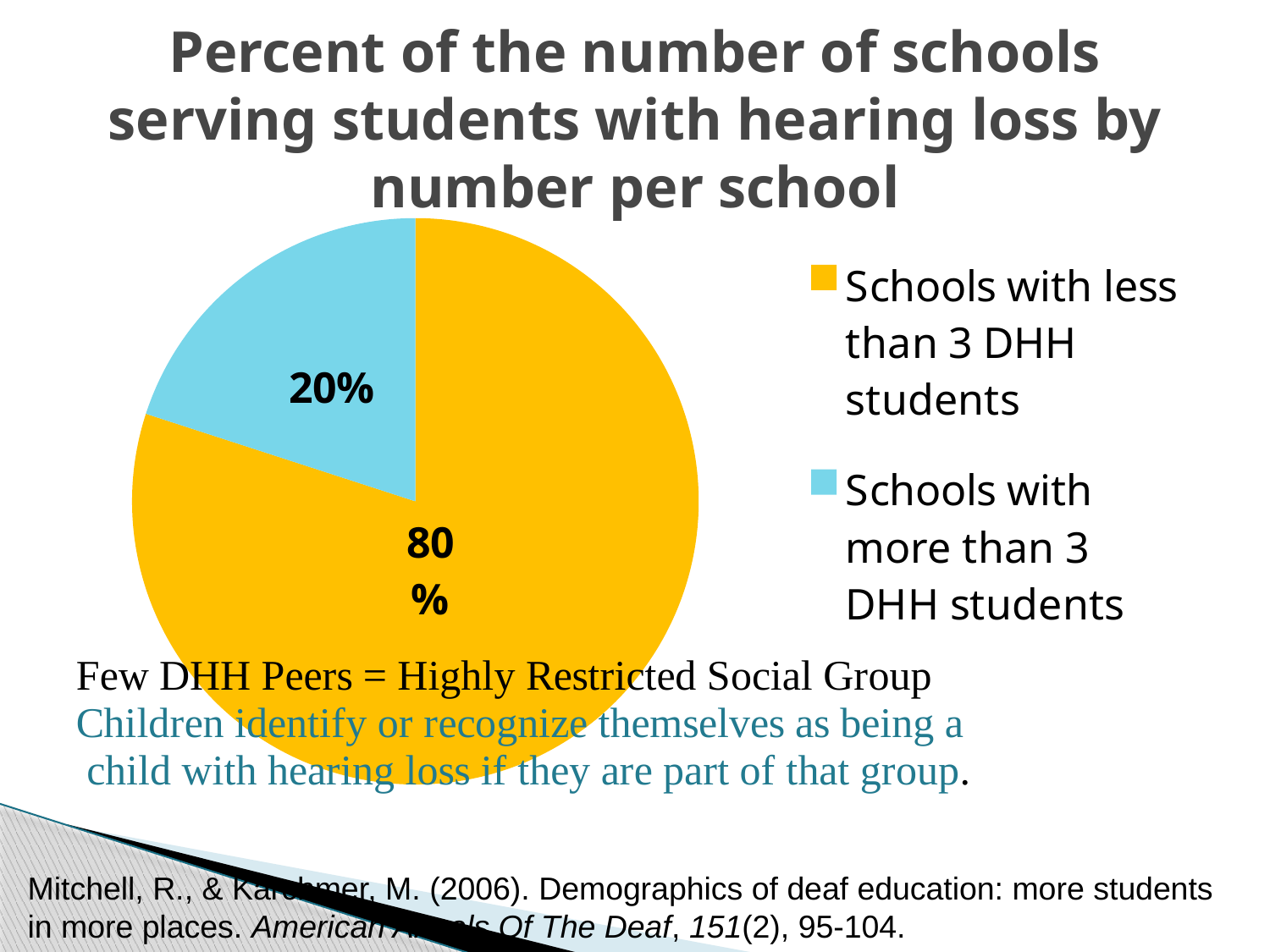
What percentage of schools have less than 3 DHH students? 80% What is the difference in percentage points between schools with less than 3 DHH students and schools with more than 3 DHH students? 60 How many slices does the pie chart have? 2 What share of the pie is taken by schools with less than 3 DHH students? 80% Which category has the largest share of the pie? Schools with less than 3 DHH students What percentage of schools have more than 3 DHH students? 20% What is the title of the chart? Percent of the number of schools serving students with hearing loss by number per school What colour is the slice for schools with more than 3 DHH students? light blue How many entries does the legend list? 2 What kind of chart is shown on the slide? pie chart Which is larger: the share for schools with less than 3 DHH students or the share for schools with more than 3 DHH students? Schools with less than 3 DHH students Which category has the smallest share of the pie? Schools with more than 3 DHH students